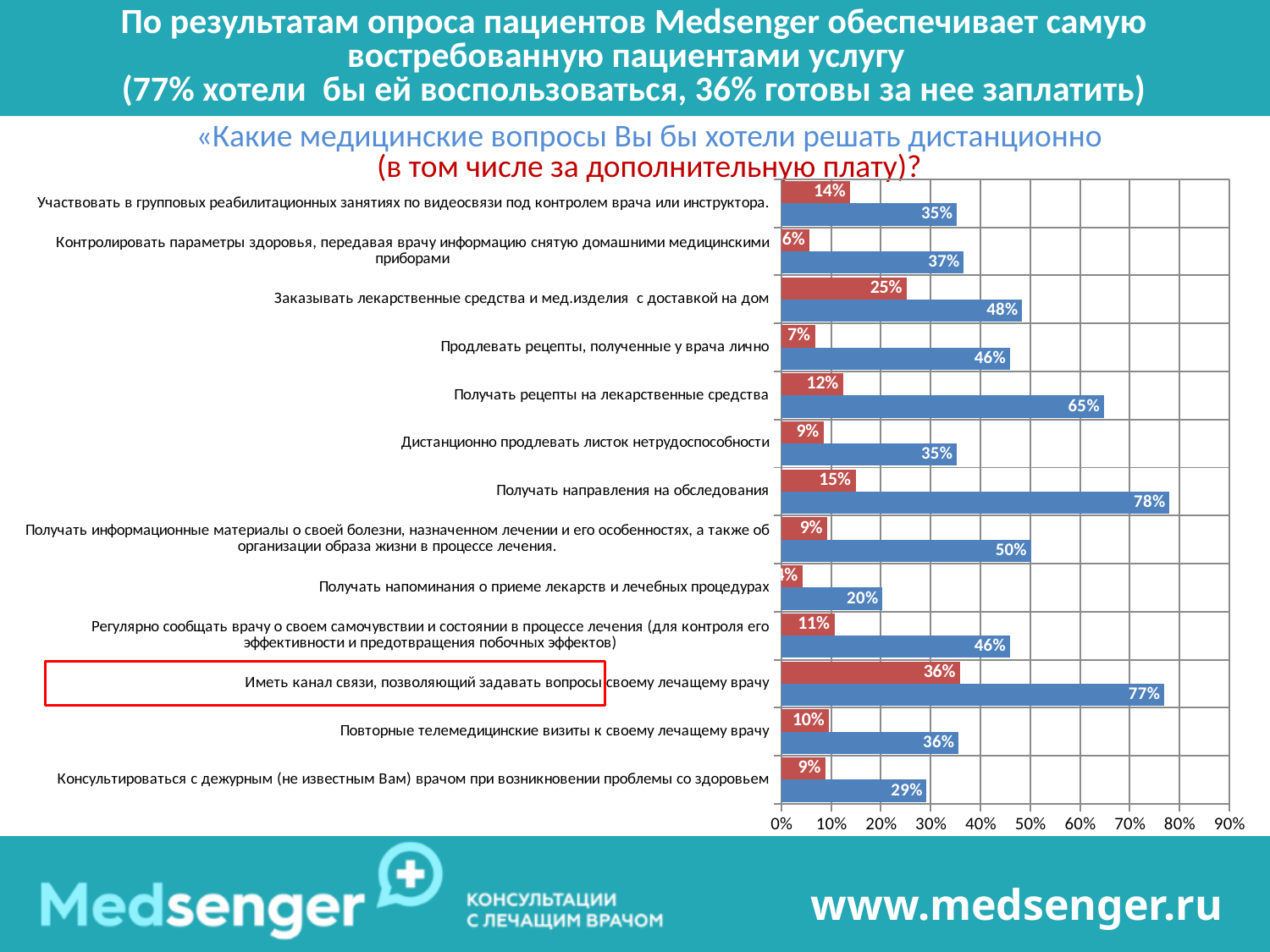
What type of chart is shown on the slide? Bar chart What is the value of the red bar for «Заказывать лекарственные средства и мед.изделия с доставкой на дом»? 25% Which category has the lowest blue bar value? Получать напоминания о приеме лекарств и лечебных процедурах What is the difference between the blue and red bar values for «Получать рецепты на лекарственные средства»? 53% Which is larger: the blue bar for «Заказывать лекарственные средства и мед.изделия с доставкой на дом» or the blue bar for «Продлевать рецепты, полученные у врача лично»? Заказывать лекарственные средства и мед.изделия с доставкой на дом Which category has the highest blue bar value? Получать направления на обследования How many categories are shown in the chart? 13 Which category has the highest red bar value? Иметь канал связи, позволяющий задавать вопросы своему лечащему врачу What is the value of the blue bar for «Получать направления на обследования»? 78% What is the value of the red bar for «Иметь канал связи, позволяющий задавать вопросы своему лечащему врачу»? 36% Is the blue bar value for «Получать информационные материалы о своей болезни...» greater or less than 40%? greater What is the value of the blue bar for «Консультироваться с дежурным (не известным Вам) врачом при возникновении проблемы со здоровьем»? 29%